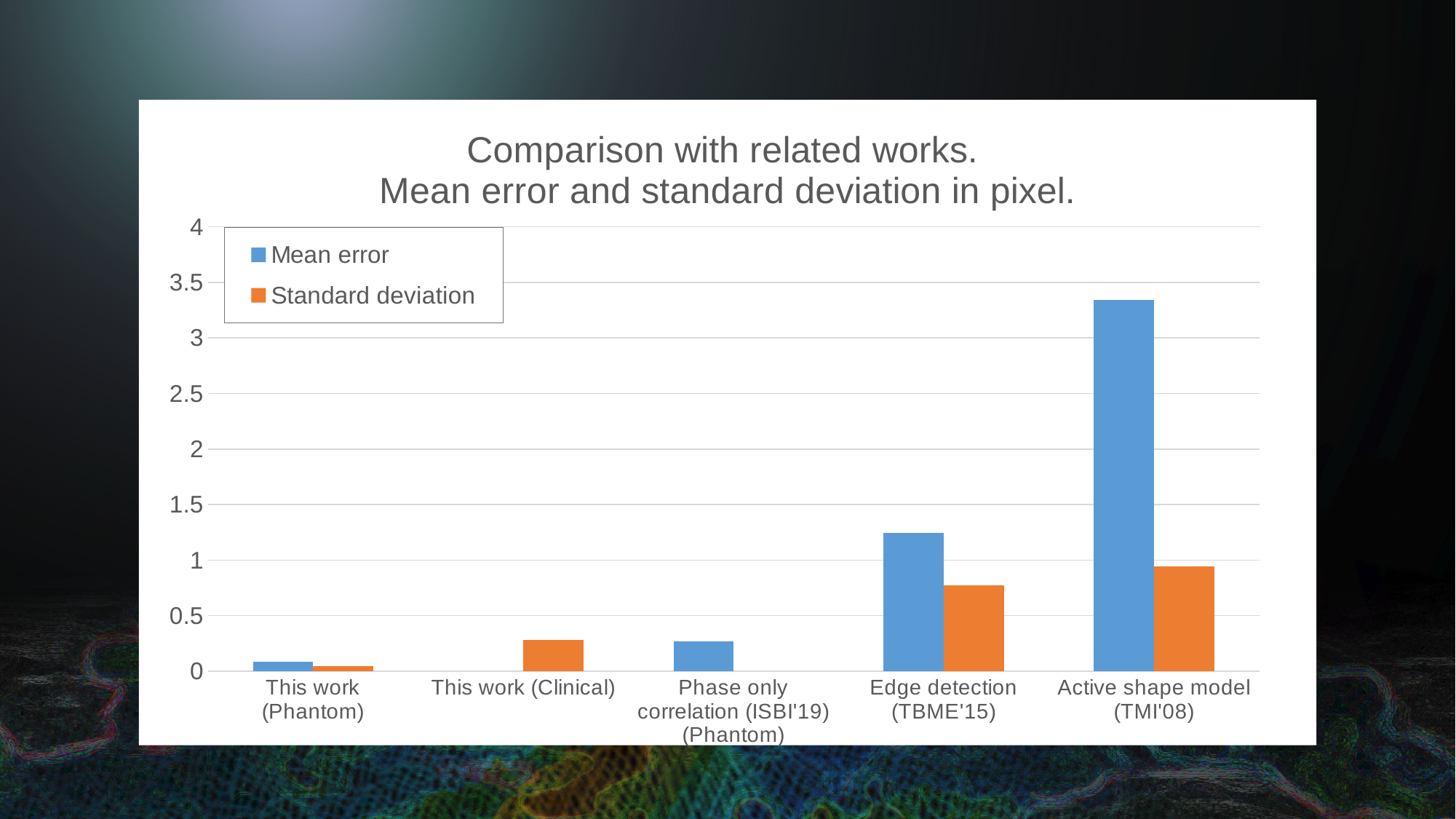
Is the Mean error for Edge detection (TBME'15) greater or less than 1? greater Which has the larger Mean error, Edge detection (TBME'15) or Active shape model (TMI'08)? Active shape model (TMI'08) How many categories are shown along the x axis? 5 How many series does the legend list? 2 Is the Standard deviation for Edge detection (TBME'15) greater or less than 1? less Which has the larger Standard deviation, This work (Clinical) or Edge detection (TBME'15)? Edge detection (TBME'15) Is the Mean error for Phase only correlation (ISBI'19) (Phantom) greater or less than 0.5? less What kind of chart is shown on the slide? bar chart What colour represents the Standard deviation series in the chart? orange Which category has the highest Mean error? Active shape model (TMI'08) Which category has the highest Standard deviation? Active shape model (TMI'08)